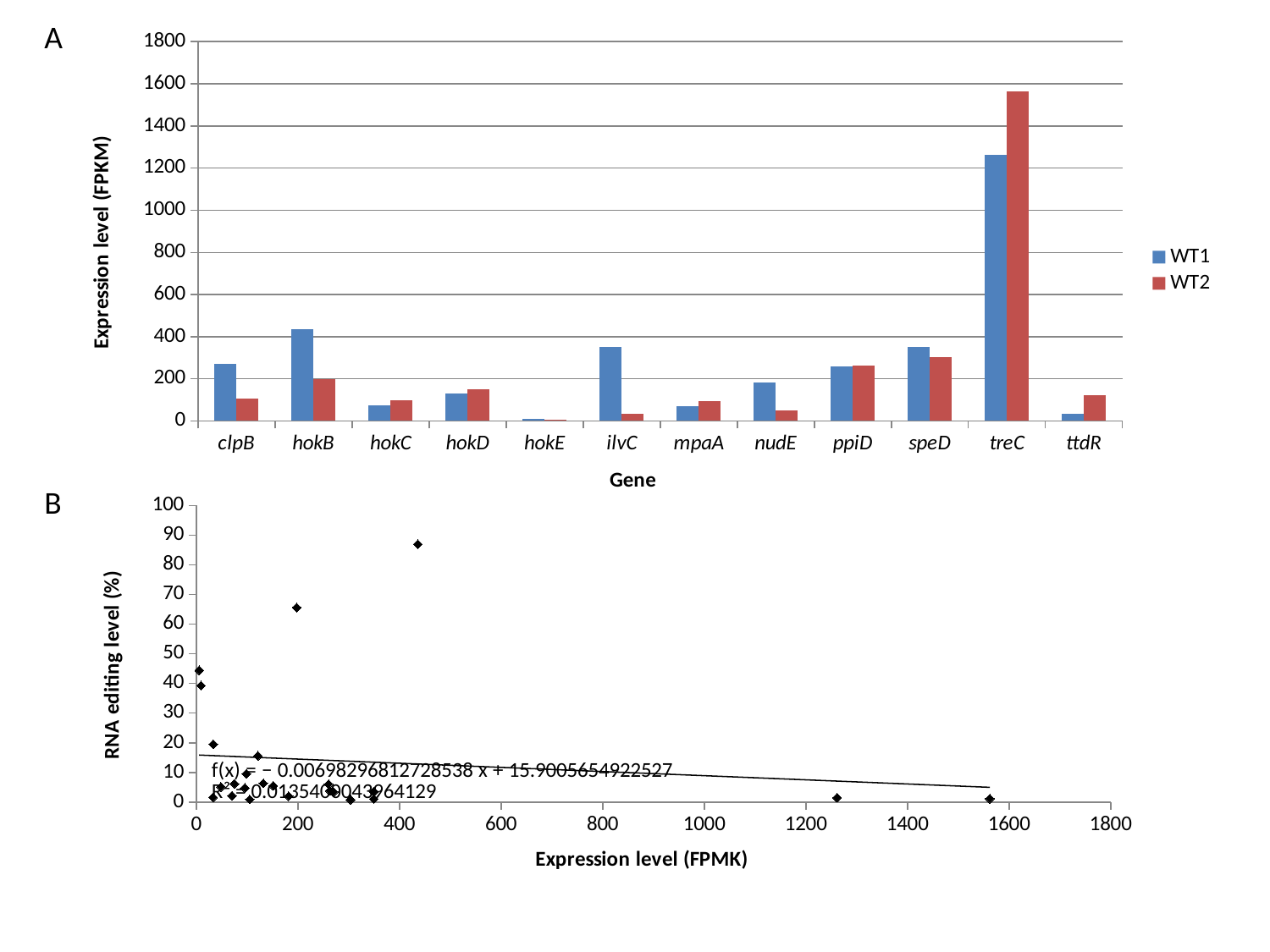
In chart A (the top chart), which is larger for ttdR, WT1 or WT2? WT2 In chart B (the bottom chart), what kind of chart is it? scatter plot In chart A (the top chart), how many series does the legend list? 2 In chart A (the top chart), which gene has the lowest WT1 expression level? hokE In chart A (the top chart), which gene has the highest WT2 expression level? treC In chart A (the top chart), what kind of chart is it? bar chart In chart A (the top chart), is the WT1 value for hokB greater or less than 400? greater In chart A (the top chart), how many genes are shown on the x axis? 12 In chart A (the top chart), is the WT2 value for treC greater or less than 1400? greater In chart B (the bottom chart), does the fitted trend line rise or fall as expression level increases? fall In chart A (the top chart), is the WT2 value for ilvC greater or less than 200? less In chart A (the top chart), which is larger for hokB, WT1 or WT2? WT1